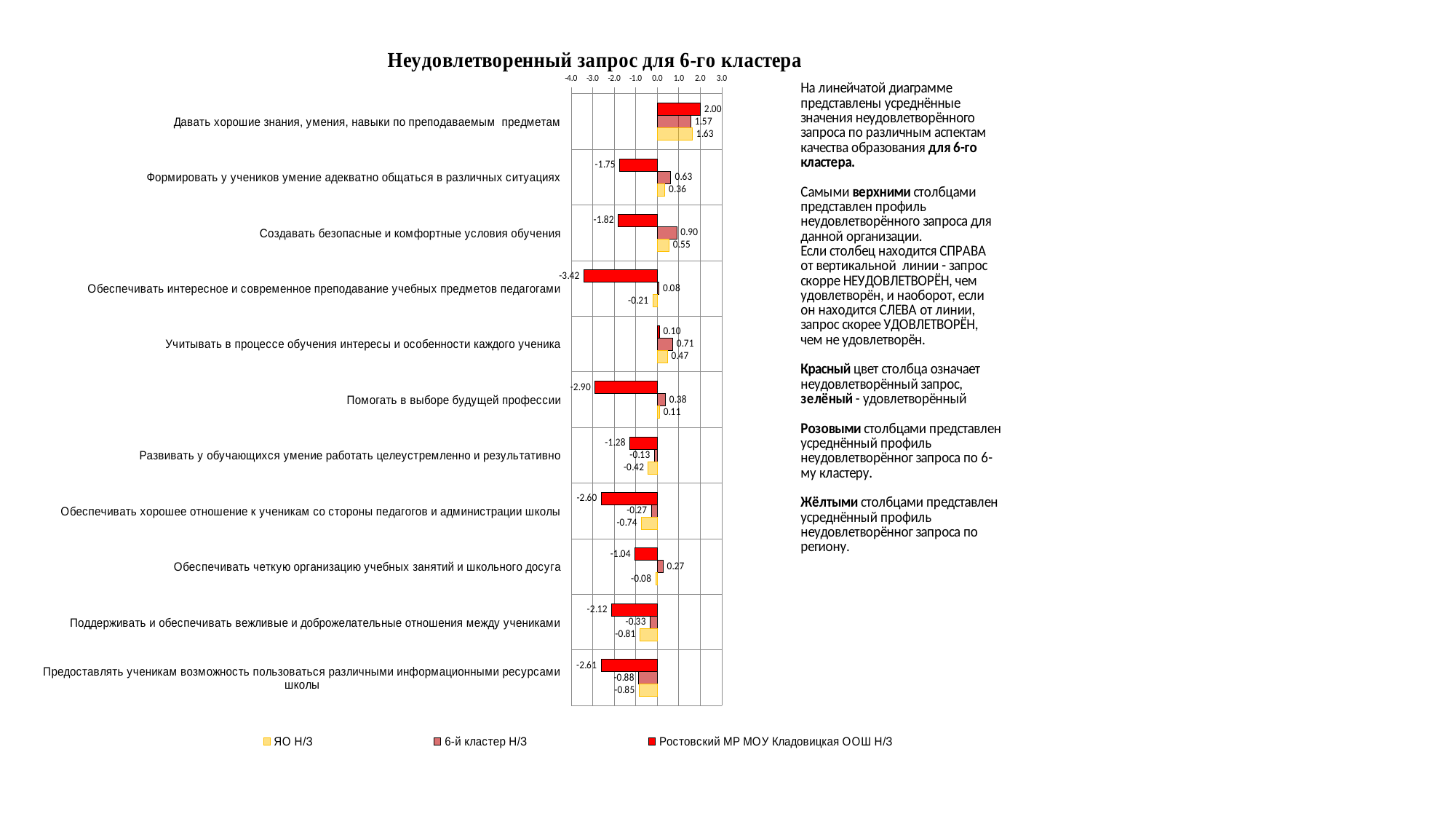
In the category "Учитывать в процессе обучения интересы и особенности каждого ученика", which series has the larger value: "6-й кластер Н/З" or "ЯО Н/З"? 6-й кластер Н/З What is the value for the series "Ростовский МР МОУ Кладовицкая ООШ Н/З" in the category "Давать хорошие знания, умения, навыки по преподаваемым предметам"? 2.00 What kind of chart is shown on the slide? Bar chart How many series does the legend list? 3 How many categories are shown on the chart? 11 What is the value for the series "6-й кластер Н/З" in the category "Создавать безопасные и комфортные условия обучения"? 0.90 In which category does the series "Ростовский МР МОУ Кладовицкая ООШ Н/З" have its lowest value? Обеспечивать интересное и современное преподавание учебных предметов педагогами What is the title of the chart? Неудовлетворенный запрос для 6-го кластера What is the difference between the "6-й кластер Н/З" value and the "ЯО Н/З" value in the category "Формировать у учеников умение адекватно общаться в различных ситуациях"? 0.27 In which category does the series "6-й кластер Н/З" have its highest value? Давать хорошие знания, умения, навыки по преподаваемым предметам What is the value for the series "ЯО Н/З" in the category "Поддерживать и обеспечивать вежливые и доброжелательные отношения между учениками"? -0.81 What is the value for the series "Ростовский МР МОУ Кладовицкая ООШ Н/З" in the category "Помогать в выборе будущей профессии"? -2.90